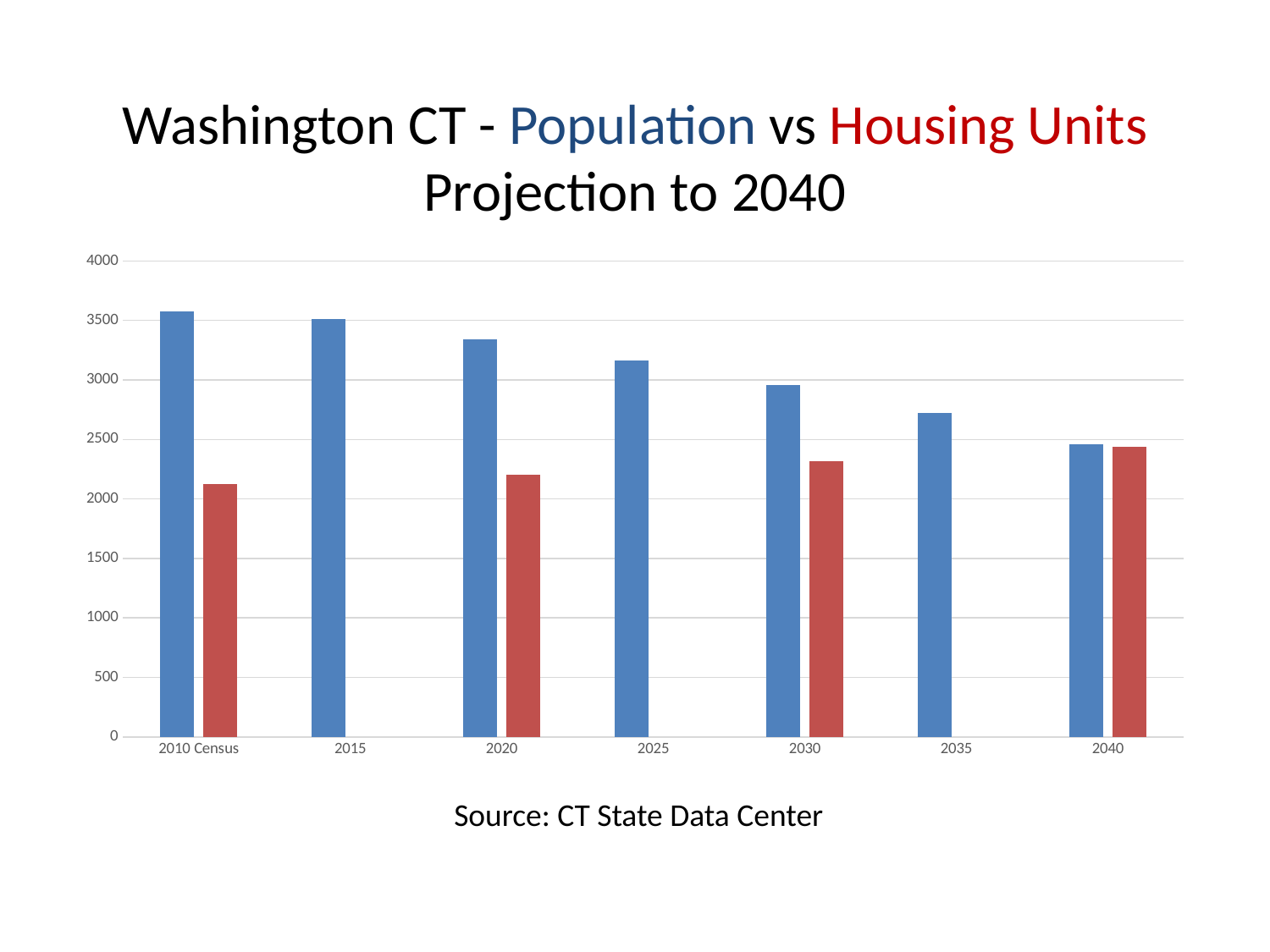
Is the Population value for 2010 Census greater or less than 3500? greater What kind of chart is shown on the slide? bar chart In 2030, which is larger, the Population bar or the Housing Units bar? Population Which year has the lowest Housing Units (red) bar? 2010 Census Which year has the highest Housing Units (red) bar? 2040 Do the Population (blue) bars rise or fall from 2010 Census to 2040? fall Which year has the lowest Population (blue) bar? 2040 Is the Housing Units value for 2010 Census greater or less than 2000? greater How many year categories are shown on the x axis? 7 Which year has the highest Population (blue) bar? 2010 Census In how many of the year categories is a red Housing Units bar plotted? 4 Is the Population value for 2035 greater or less than 3000? less